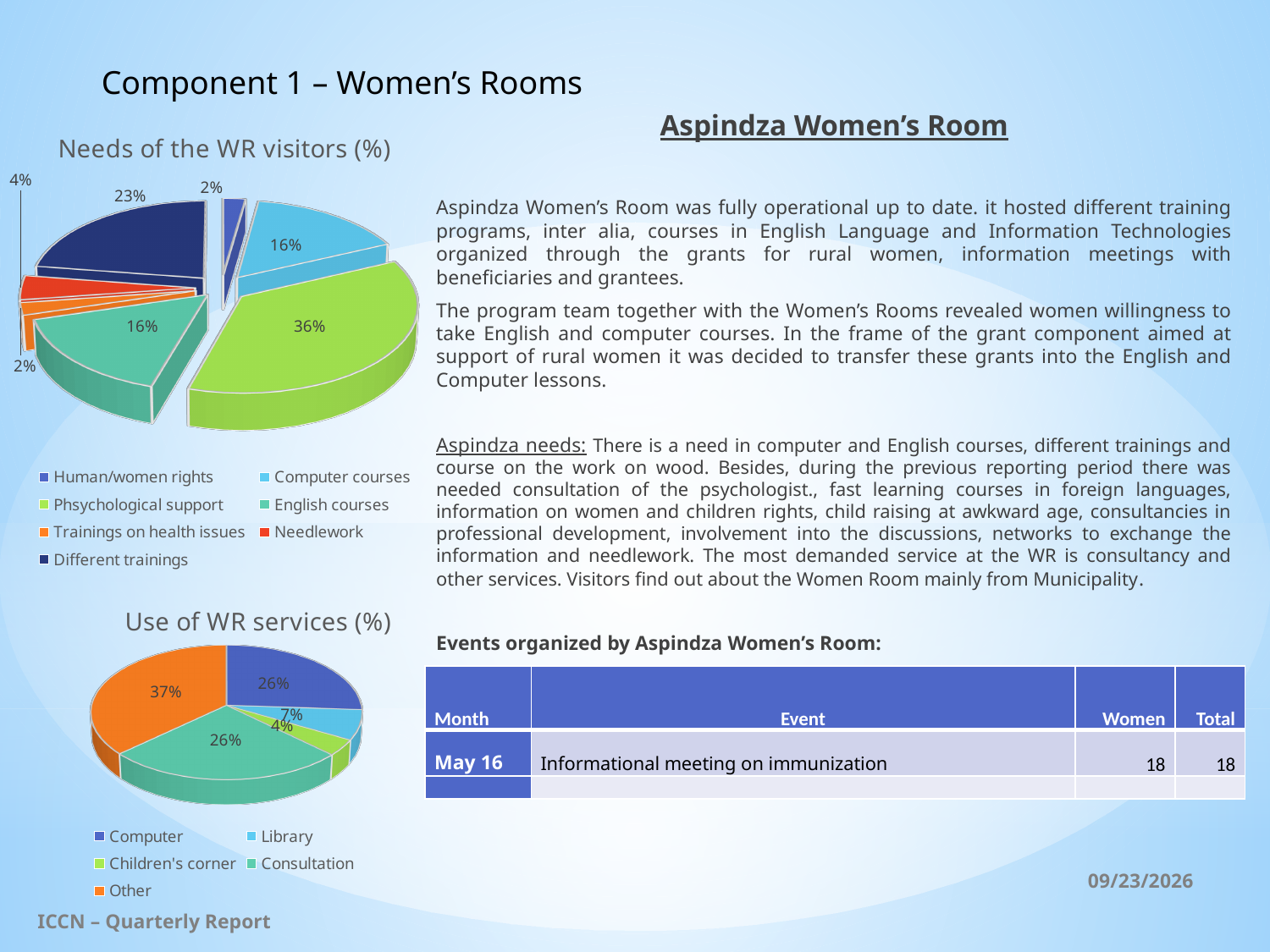
In the 'Needs of the WR visitors (%)' chart, how many categories does the legend list? 7 In the 'Use of WR services (%)' chart, which category has the smallest slice? Children's corner In the 'Needs of the WR visitors (%)' chart, what percentage is shown for Phsychological support? 36% In the 'Use of WR services (%)' chart, which is larger, Computer or Library? Computer In the 'Needs of the WR visitors (%)' chart, what is the difference between the Phsychological support and Different trainings slices? 13 percentage points In the 'Use of WR services (%)' chart, how many categories does the legend list? 5 In the 'Needs of the WR visitors (%)' chart, what percentage is shown for Computer courses? 16% In the 'Use of WR services (%)' chart, what percentage is shown for Other? 37% In the 'Needs of the WR visitors (%)' chart, which category has the largest slice? Phsychological support What kind of chart is 'Needs of the WR visitors (%)'? Pie chart In the 'Needs of the WR visitors (%)' chart, what percentage is shown for Different trainings? 23% In the 'Use of WR services (%)' chart, what percentage is shown for Library? 7%